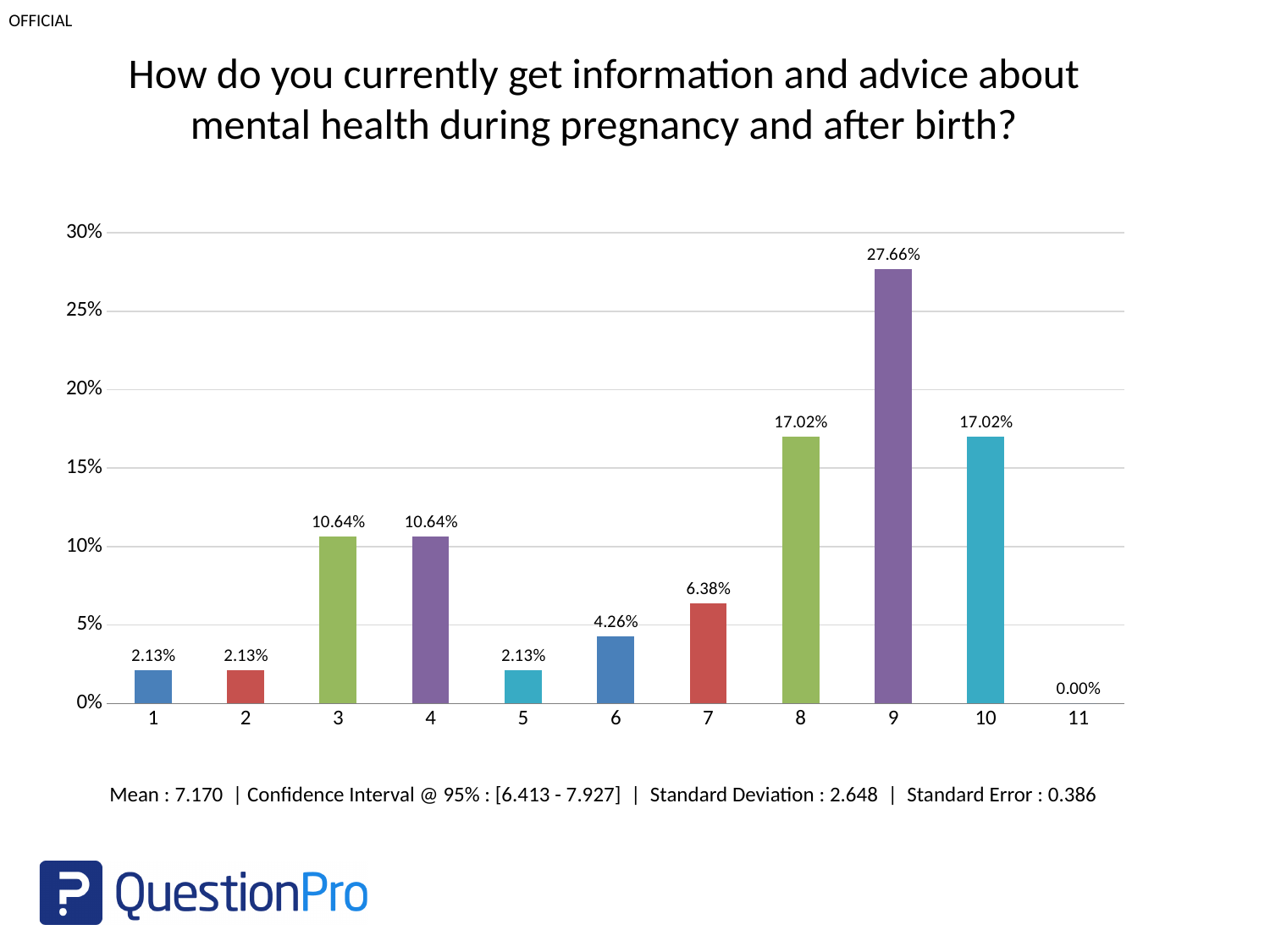
What is the mean reported below the chart? 7.170 What is the value for category 9? 27.66% Which category has the lowest value? 11 What kind of chart is shown on the slide? bar chart Which is larger, the value for category 6 or the value for category 7? 7 What is the value for category 11? 0.00% What is the value for category 7? 6.38% What is the title of the chart? How do you currently get information and advice about mental health during pregnancy and after birth? How many categories are shown on the x axis? 11 Is the value for category 9 greater or less than 25%? greater What is the difference between the values for category 9 and category 8? 10.64% Which category has the highest value? 9